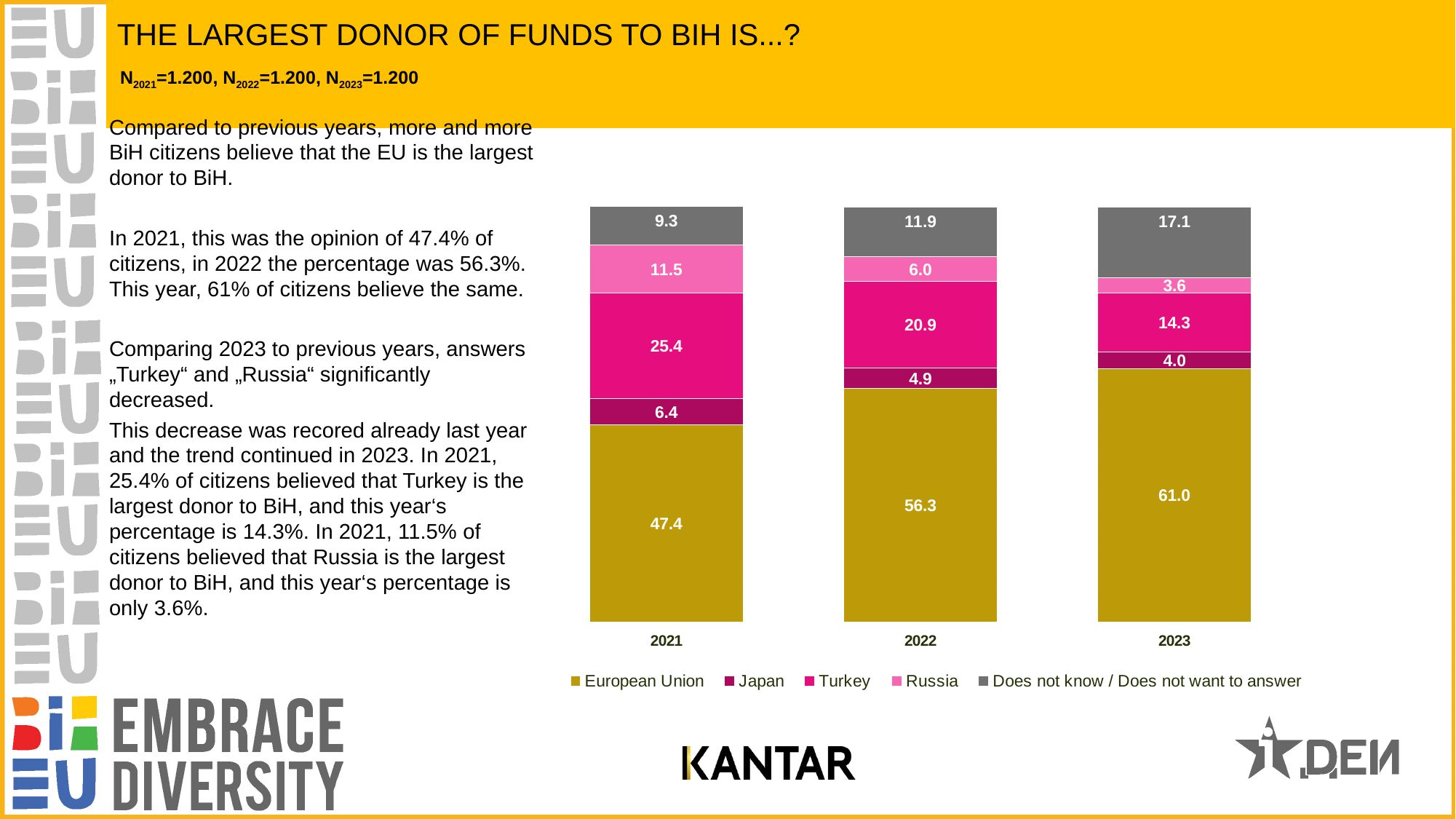
What is the value for European Union in 2022? 56.3 What is the value for Russia in 2023? 3.6 How many years (categories) are shown on the x axis? 3 What is the value for Japan in 2022? 4.9 Does the European Union value rise or fall from 2021 to 2023? Rise Which is larger: the 'Does not know / Does not want to answer' value in 2021 or in 2023? 2023 What is the value for Turkey in 2021? 25.4 What kind of chart is shown on the slide? Stacked bar chart In which year is the Russia value lowest? 2023 How many series does the legend list? 5 In which year is the European Union value highest? 2023 What is the difference between the Turkey values in 2021 and 2023? 11.1